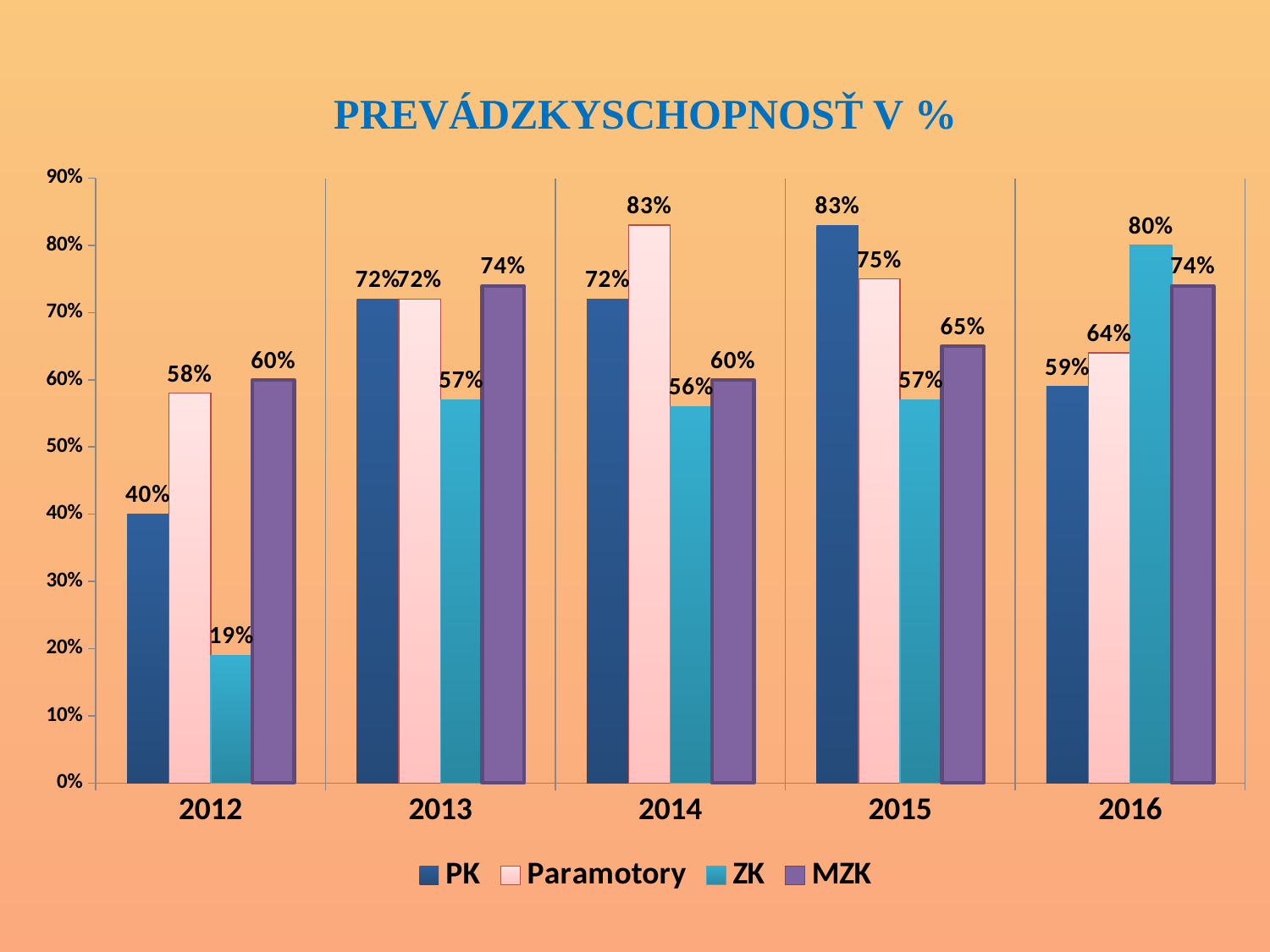
What is the title of the chart? PREVÁDZKYSCHOPNOSŤ V % How many series does the legend list? 4 Does the PK value rise or fall from 2015 to 2016? Fall What kind of chart is shown on the slide? Bar chart What is the difference between the ZK value in 2016 and the ZK value in 2012? 61% Which is larger in 2015: the PK value or the Paramotory value? PK In which year is the PK value highest? 2015 What is the value for ZK in 2012? 19% What is the value for MZK in 2016? 74% In which year is the ZK value lowest? 2012 What is the value for Paramotory in 2014? 83% How many years are shown on the x axis? 5